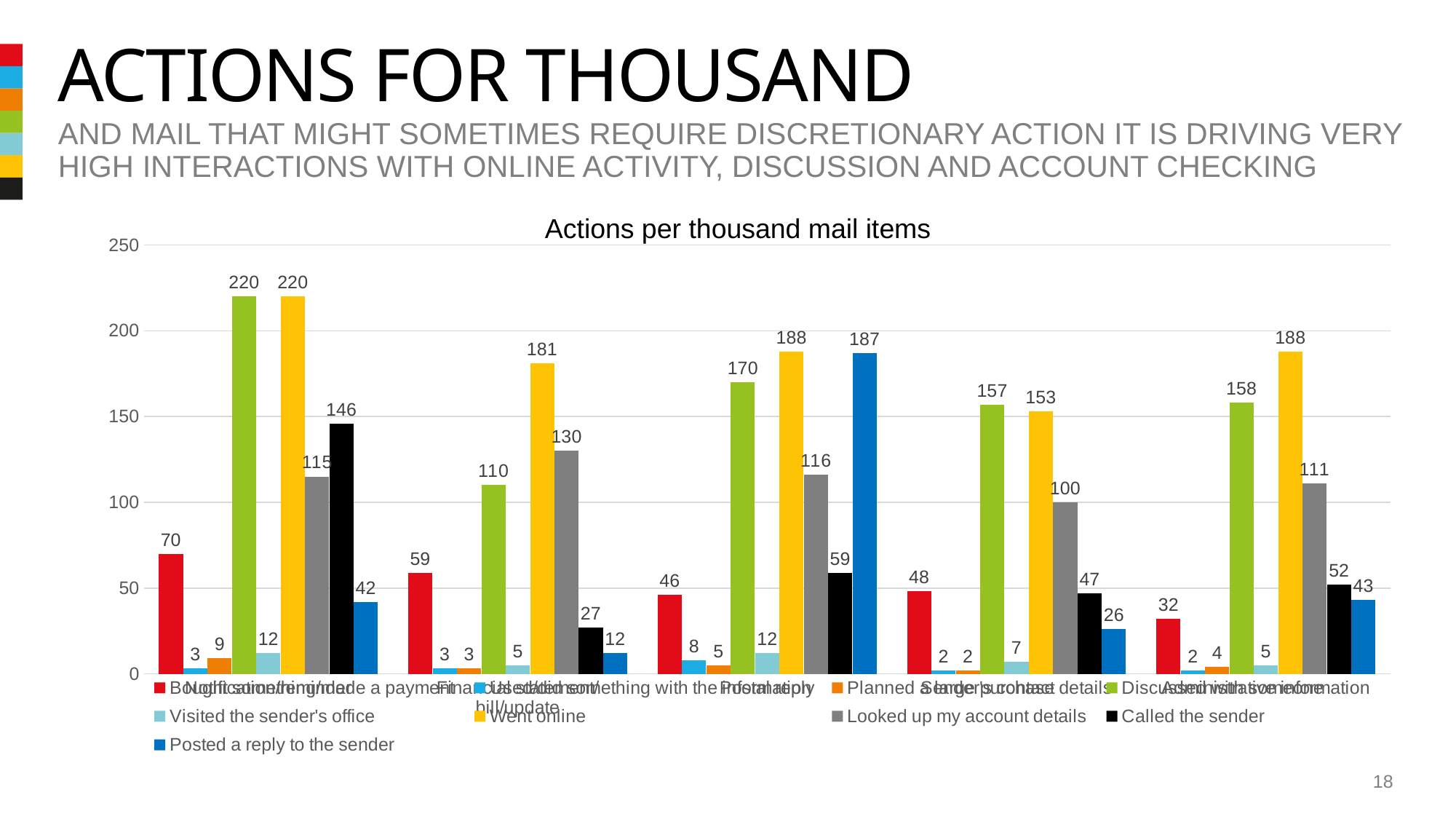
What kind of chart is shown on the slide? bar chart In the middle group of bars, is the value for 'Posted a reply to the sender' greater or less than 150? greater In the second group of bars from the left, which is larger: 'Looked up my account details' or 'Discussed with someone'? Looked up my account details How many series does the chart's legend list? 9 In the leftmost group of bars, what is the value for 'Called the sender'? 146 In the leftmost group of bars, what is the value for 'Went online'? 220 In the rightmost group of bars, what is the value for 'Looked up my account details'? 111 How many groups of bars are plotted along the x axis? 5 In the second group of bars from the left, which series has the highest value? Went online In the leftmost group of bars, what is the difference between 'Called the sender' and 'Posted a reply to the sender'? 104 In the rightmost group of bars, which series has the highest value? Went online What is the title of the chart? Actions per thousand mail items